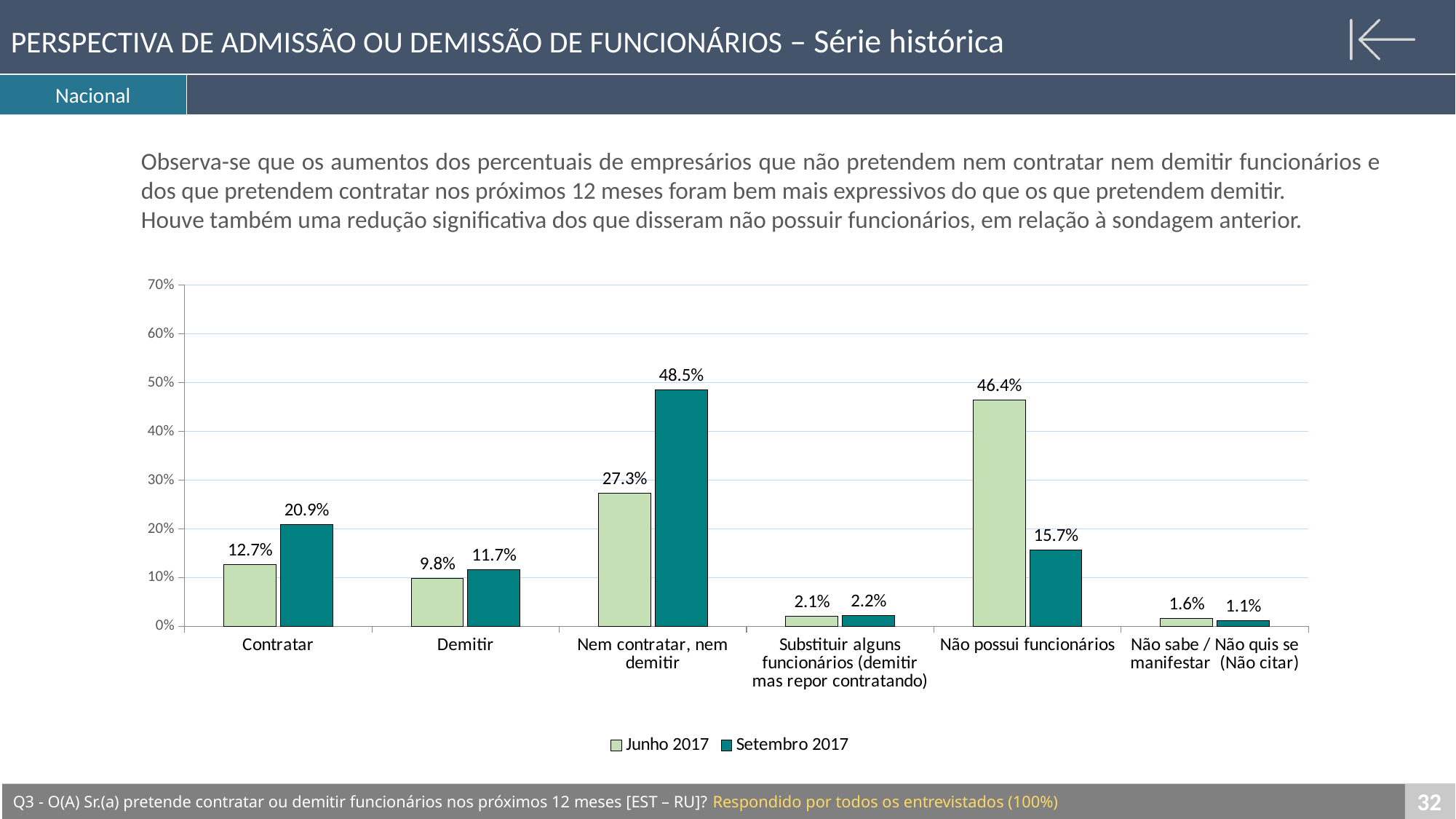
Which category has the lowest value in Junho 2017? Não sabe / Não quis se manifestar (Não citar) What is the value for Não possui funcionários in Junho 2017? 46.4% Which series is shown in dark teal in the legend? Setembro 2017 What is the value for Contratar in Setembro 2017? 20.9% What kind of chart is shown on the slide? Bar chart What is the difference between the Setembro 2017 and Junho 2017 values for Nem contratar, nem demitir? 21.2% Which is larger for Contratar: the Junho 2017 value or the Setembro 2017 value? Setembro 2017 How many series does the legend list? 2 Which category has the highest value in Setembro 2017? Nem contratar, nem demitir What is the difference between the Junho 2017 and Setembro 2017 values for Não possui funcionários? 30.7% How many categories are shown on the x axis? 6 What is the value for Demitir in Junho 2017? 9.8%